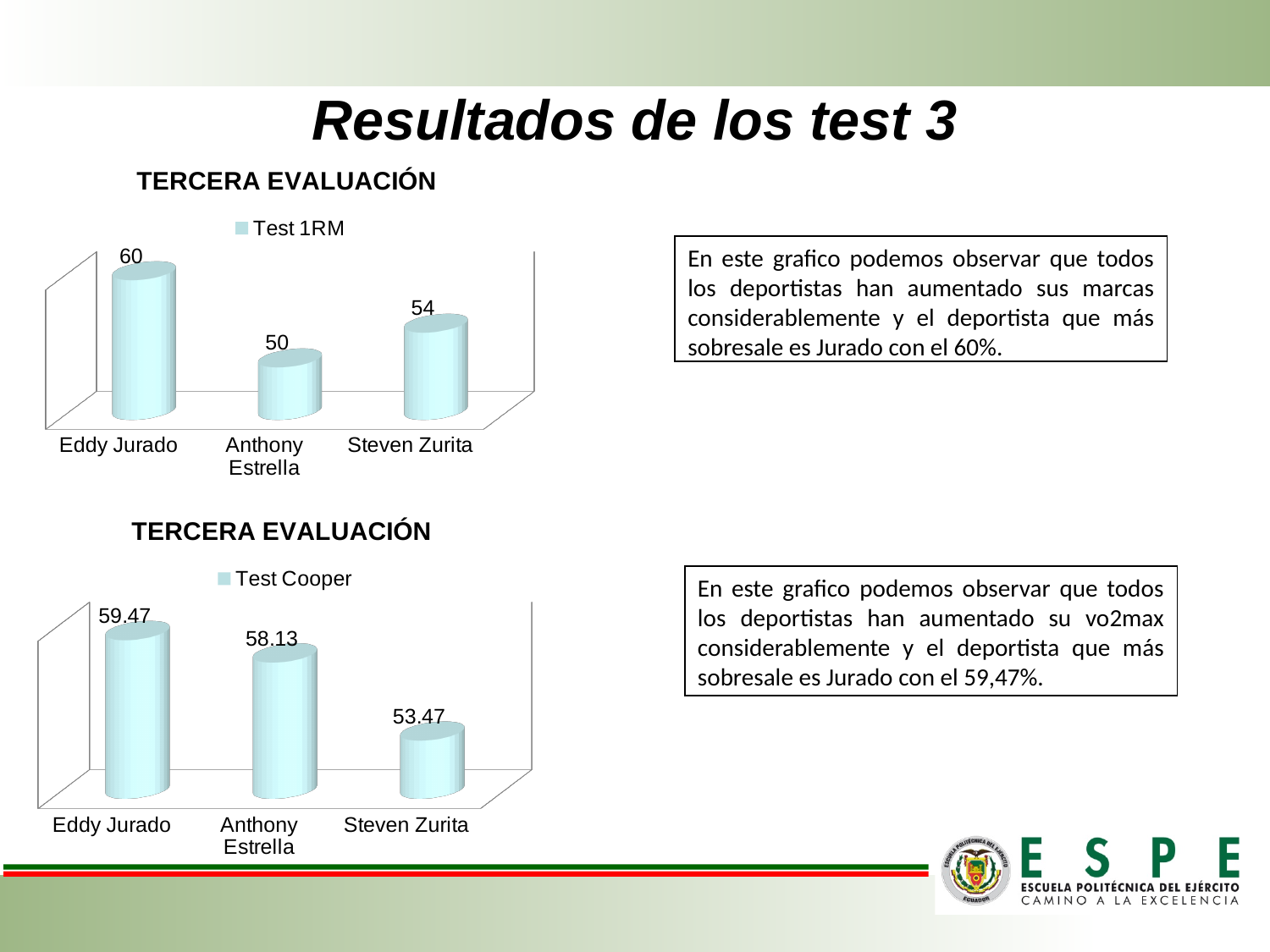
In the top chart (Test 1RM), which athlete has the lowest value? Anthony Estrella In the bottom chart (Test Cooper), what is the difference between Anthony Estrella's and Steven Zurita's values? 4.66 In the bottom chart (Test Cooper), is the value for Eddy Jurado or Anthony Estrella larger? Eddy Jurado In the top chart (Test 1RM), what is the difference between Eddy Jurado's and Steven Zurita's values? 6 In the bottom chart (Test Cooper), what is the value for Steven Zurita? 53.47 In the top chart (Test 1RM), how many athletes are shown? 3 In the top chart (Test 1RM), what is the value for Eddy Jurado? 60 What kind of chart is the bottom chart (Test Cooper)? Bar chart What series name does the legend of the top chart show? Test 1RM In the top chart (Test 1RM), what is the value for Anthony Estrella? 50 In the bottom chart (Test Cooper), what is the value for Anthony Estrella? 58.13 In the bottom chart (Test Cooper), which athlete has the highest value? Eddy Jurado